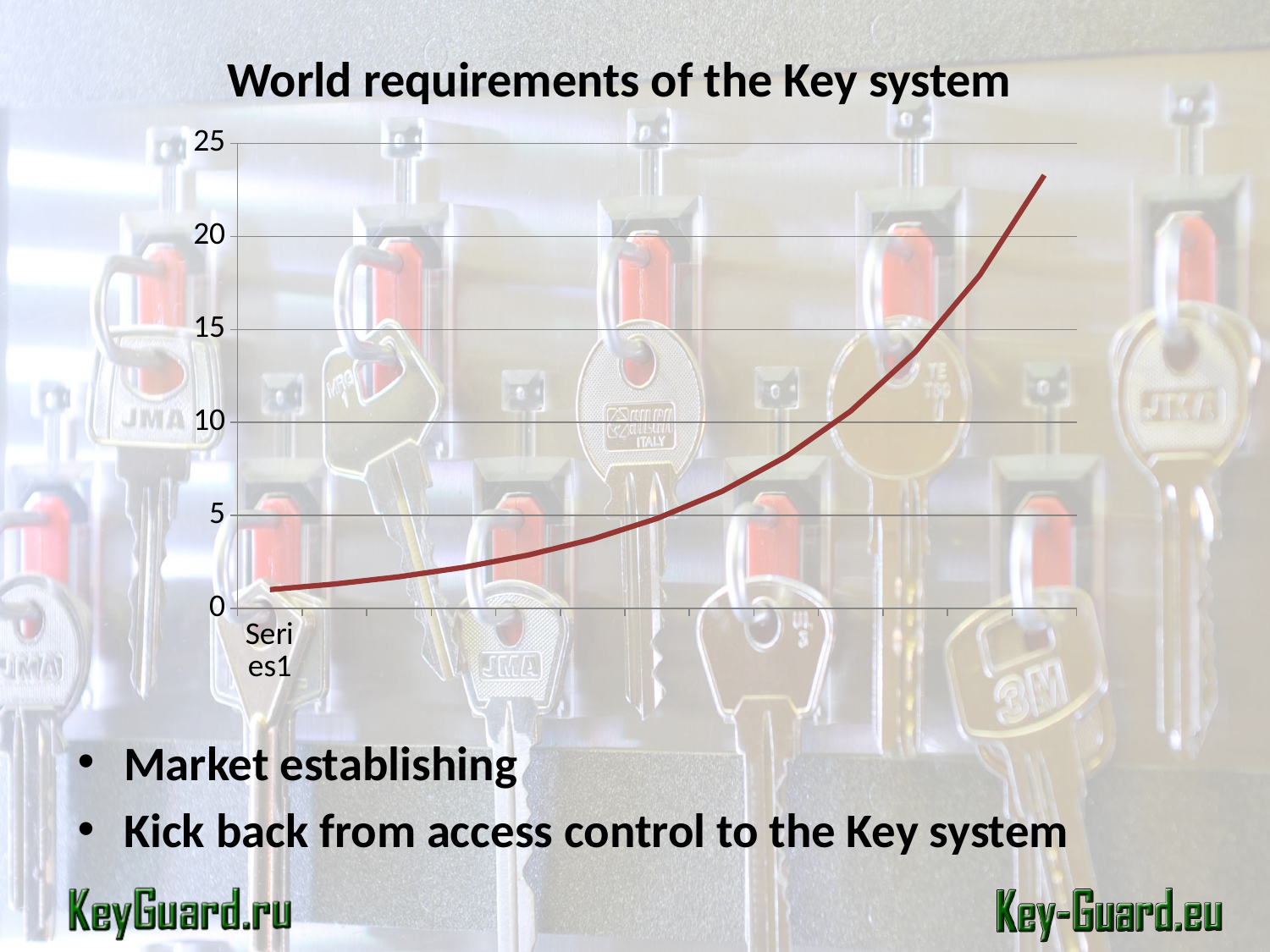
What colour is the plotted line? dark red Do the values of the line rise or fall from left to right along the x axis? rise What is the title of the chart? World requirements of the Key system What kind of chart is shown on the slide? line chart Is the lowest value of the line at the left end or the right end of the x axis? left end Is the value at the right end of the line greater or less than 20? greater Which is larger, the value at the left end of the line or the value at the right end? right end Is the highest value of the line at the left end or the right end of the x axis? right end Is the value at the right end of the line greater or less than 25? less Is the value at the left end of the line greater or less than 10? less